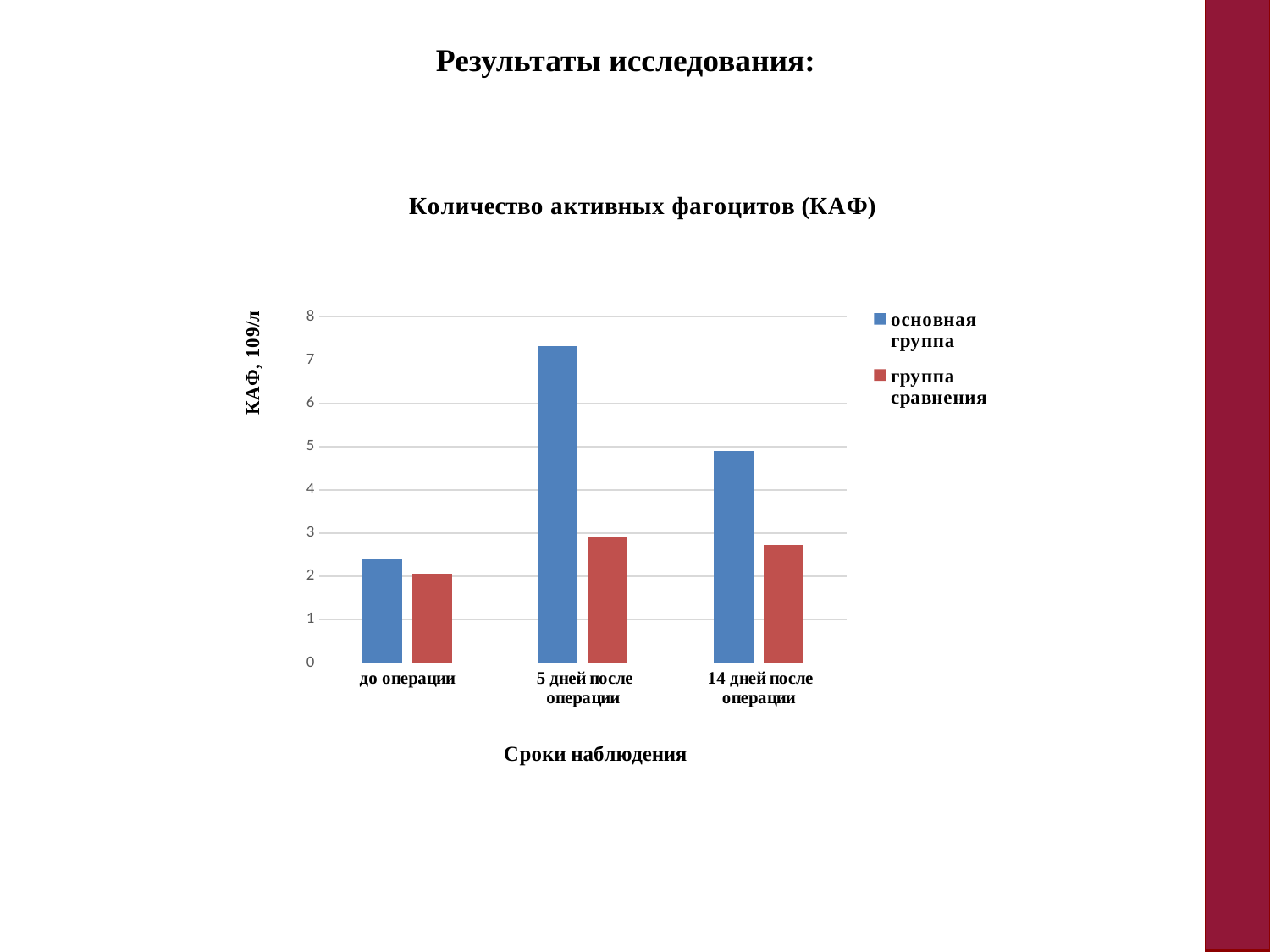
Which category has the highest value for основная группа? 5 дней после операции How many categories are shown on the x axis? 3 How many series does the legend list? 2 Which category has the lowest value for группа сравнения? до операции What kind of chart is shown on the slide? bar chart Which category has the lowest value for основная группа? до операции What is the title of the chart? Количество активных фагоцитов (КАФ) At 14 дней после операции, which series has the larger value: основная группа or группа сравнения? основная группа Is the value for основная группа at 5 дней после операции greater or less than 7? greater What is the label of the x axis? Сроки наблюдения